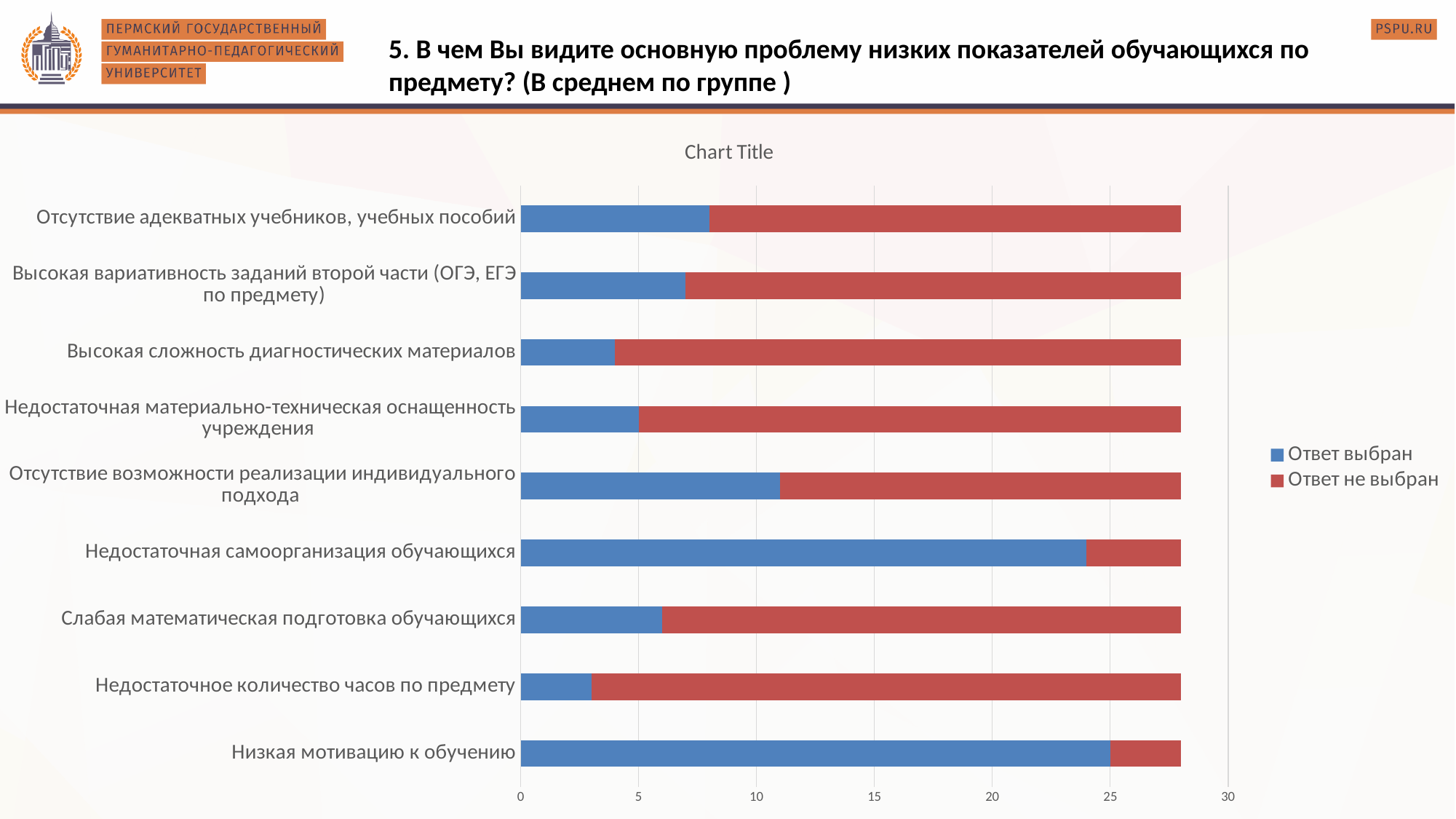
Is the 'Ответ выбран' value for 'Высокая сложность диагностических материалов' greater or less than 10? less Is the 'Ответ выбран' value for 'Недостаточная самоорганизация обучающихся' greater or less than 20? greater How many series does the chart legend list? 2 Is the 'Ответ выбран' value for 'Недостаточное количество часов по предмету' greater or less than 5? less What kind of chart is shown on the slide? bar chart What colour represents the series 'Ответ выбран'? blue What are the two series named in the legend? Ответ выбран, Ответ не выбран Which has the larger 'Ответ выбран' value: 'Недостаточная самоорганизация обучающихся' or 'Слабая математическая подготовка обучающихся'? Недостаточная самоорганизация обучающихся Which has the larger 'Ответ выбран' value: 'Отсутствие адекватных учебников, учебных пособий' or 'Недостаточное количество часов по предмету'? Отсутствие адекватных учебников, учебных пособий How many categories are plotted on the chart? 9